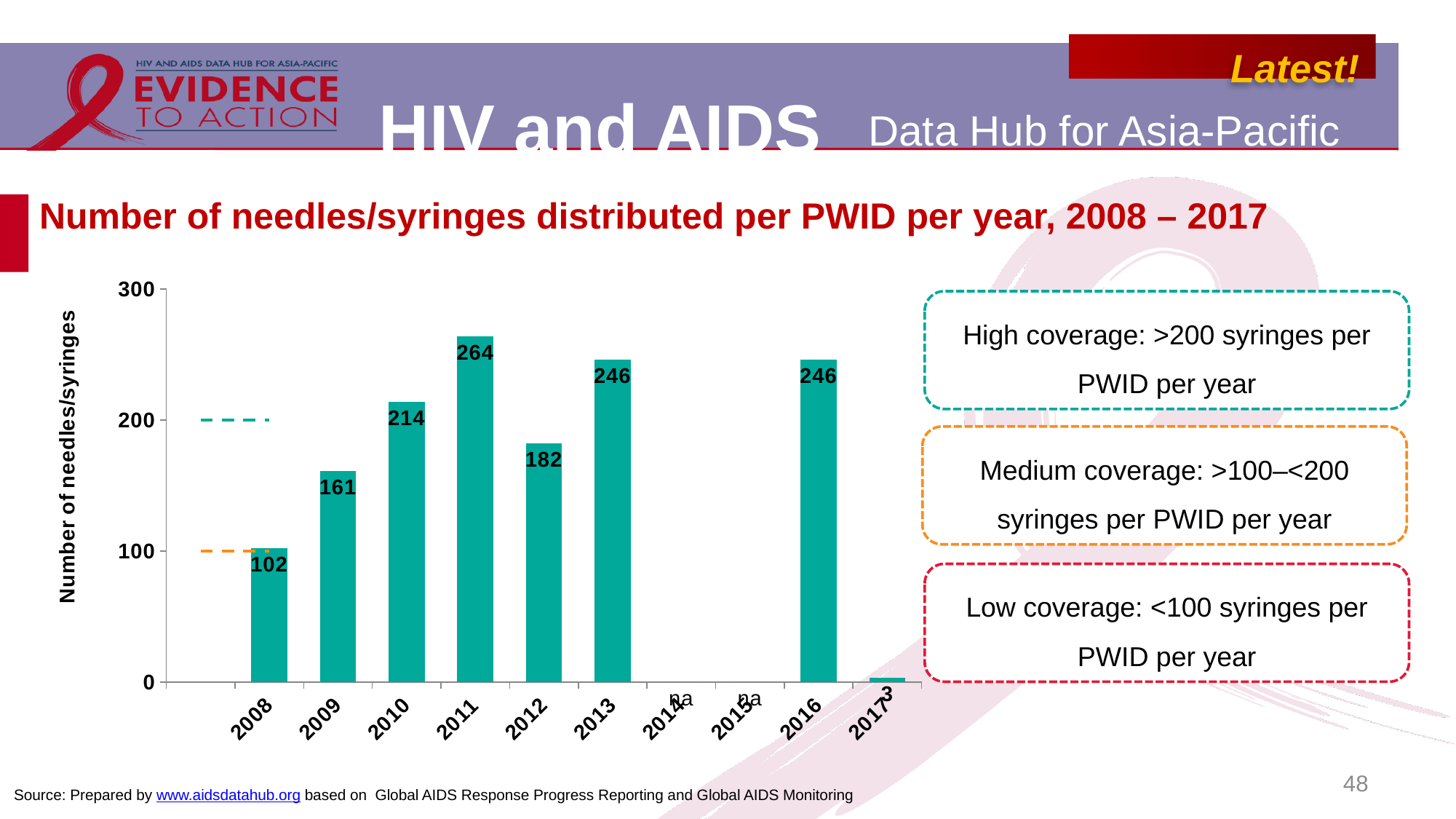
Which is larger, the value for 2010 or the value for 2012? 2010 How many years are shown on the x axis? 10 What is the difference between the values for 2009 and 2008? 59 What kind of chart is shown on the slide? bar chart What is the difference between the values for 2011 and 2010? 50 What is the value shown for 2012? 182 Is the value for 2013 greater or less than 200? greater Which year has the highest number of needles/syringes distributed per PWID? 2011 What is the number of needles/syringes distributed per PWID in 2011? 264 What is the value shown for 2017? 3 What label is shown for 2014 and 2015 instead of a value? na What is the value shown for 2008? 102